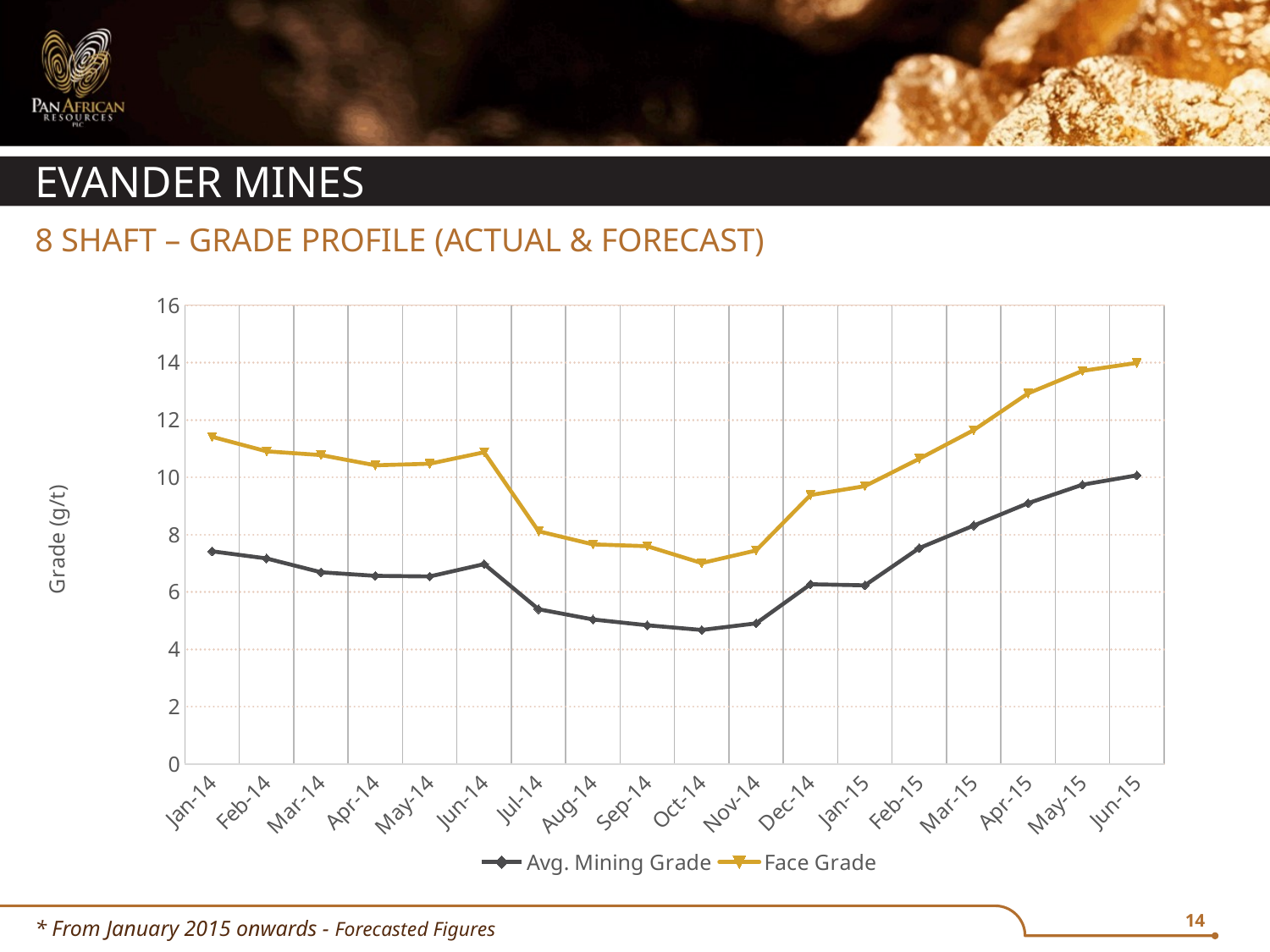
In which month does the Face Grade series reach its lowest value? Oct-14 What kind of chart is shown on the slide? Line chart How many series does the legend list? 2 How many months are plotted along the x axis? 18 Which series is higher in Jan-14, Avg. Mining Grade or Face Grade? Face Grade Is the Avg. Mining Grade value for Oct-14 greater or less than 6? less In which month does the Avg. Mining Grade series reach its lowest value? Oct-14 Is the Face Grade value for Jan-14 greater or less than 10? greater In which month does the Face Grade series reach its highest value? Jun-15 What is the label on the y axis? Grade (g/t) Do the Face Grade values rise or fall from Nov-14 to Jun-15? Rise Is the Face Grade value for Oct-14 greater or less than 8? less